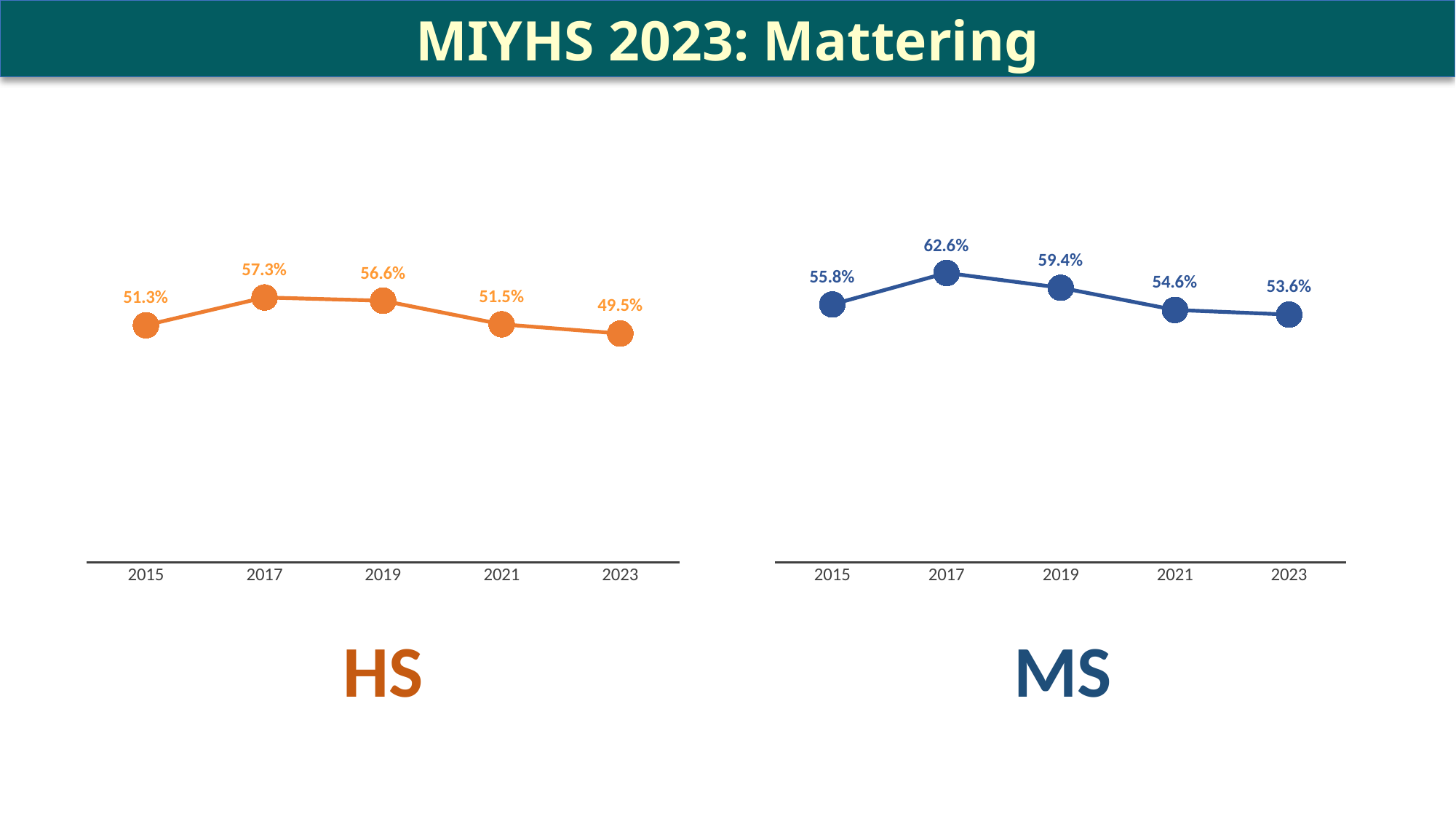
In the HS chart, what is the difference between the 2017 value and the 2023 value? 7.8% In the MS chart, do the values rise or fall from 2017 to 2023? Fall In the HS chart, how many data points are plotted? 5 In the MS chart, which year has the lowest value? 2023 What is the title of the slide containing the two charts? MIYHS 2023: Mattering In the MS chart, what is the difference between the 2015 value and the 2017 value? 6.8% What type of chart is the MS chart? Line chart In the HS chart, which year has the highest value? 2017 In the HS chart, what is the value for 2015? 51.3% In the MS chart, what is the value for 2017? 62.6% In the HS chart, what is the value for 2023? 49.5% Which is larger: the HS chart's 2019 value or the MS chart's 2019 value? MS chart's 2019 value